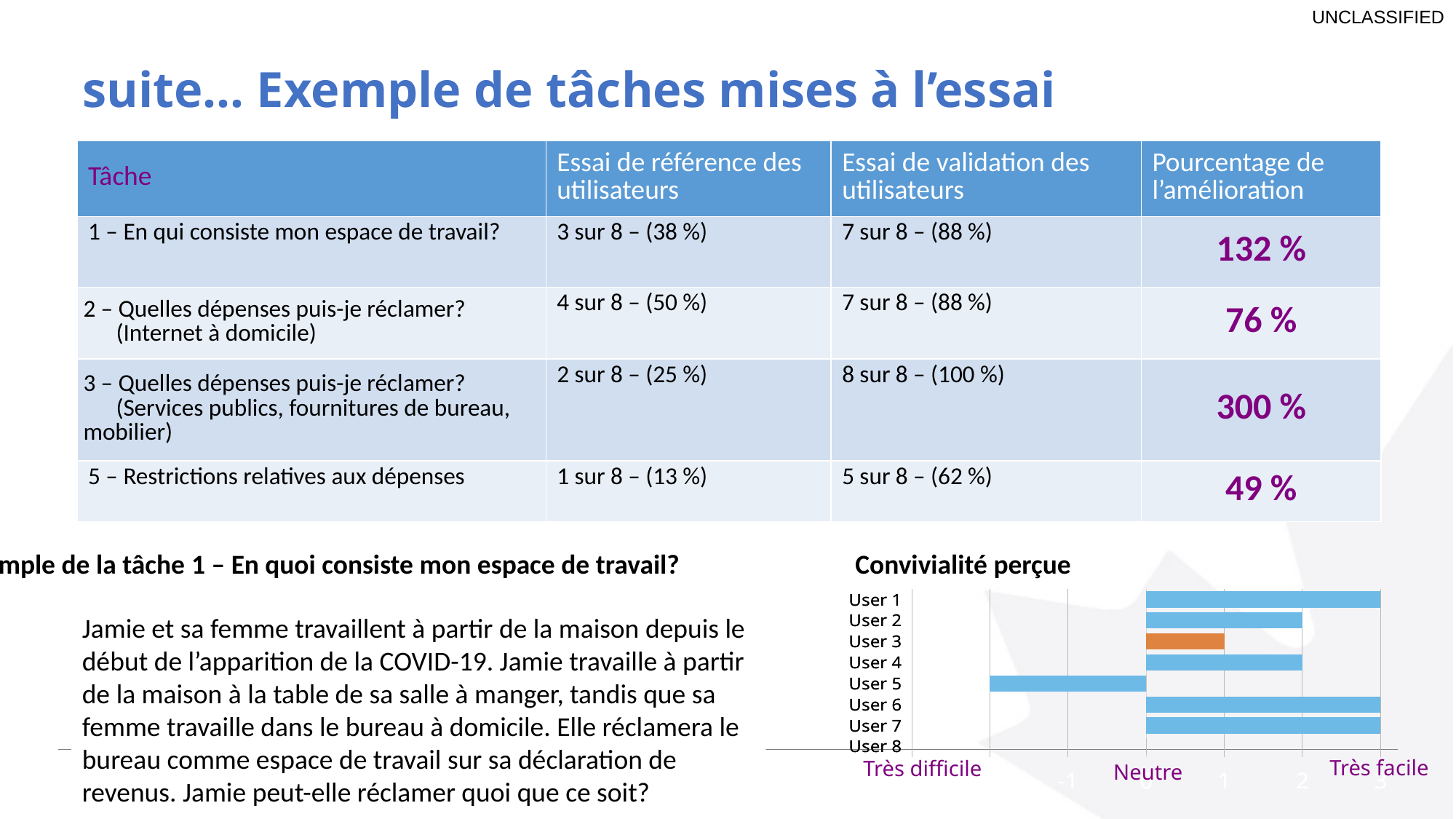
In the 'Convivialité perçue' chart, what is the value for User 3? 1 In the 'Convivialité perçue' chart, is the value for User 1 greater or less than 2? greater In the 'Convivialité perçue' chart, which user's bar is coloured orange? User 3 How many users are listed on the y axis of the 'Convivialité perçue' chart? 8 In the 'Convivialité perçue' chart, is the value for User 5 greater or less than -1? less In the 'Convivialité perçue' chart, is the value for User 6 greater or less than 2? greater In the 'Convivialité perçue' chart, which user has the lowest value? User 5 What kind of chart is the 'Convivialité perçue' chart? bar chart In the 'Convivialité perçue' chart, what is the value for User 4? 2 In the 'Convivialité perçue' chart, what is the difference between the values for User 2 and User 3? 1 In the 'Convivialité perçue' chart, what is the value for User 2? 2 In the 'Convivialité perçue' chart, which is larger, the value for User 2 or the value for User 3? User 2